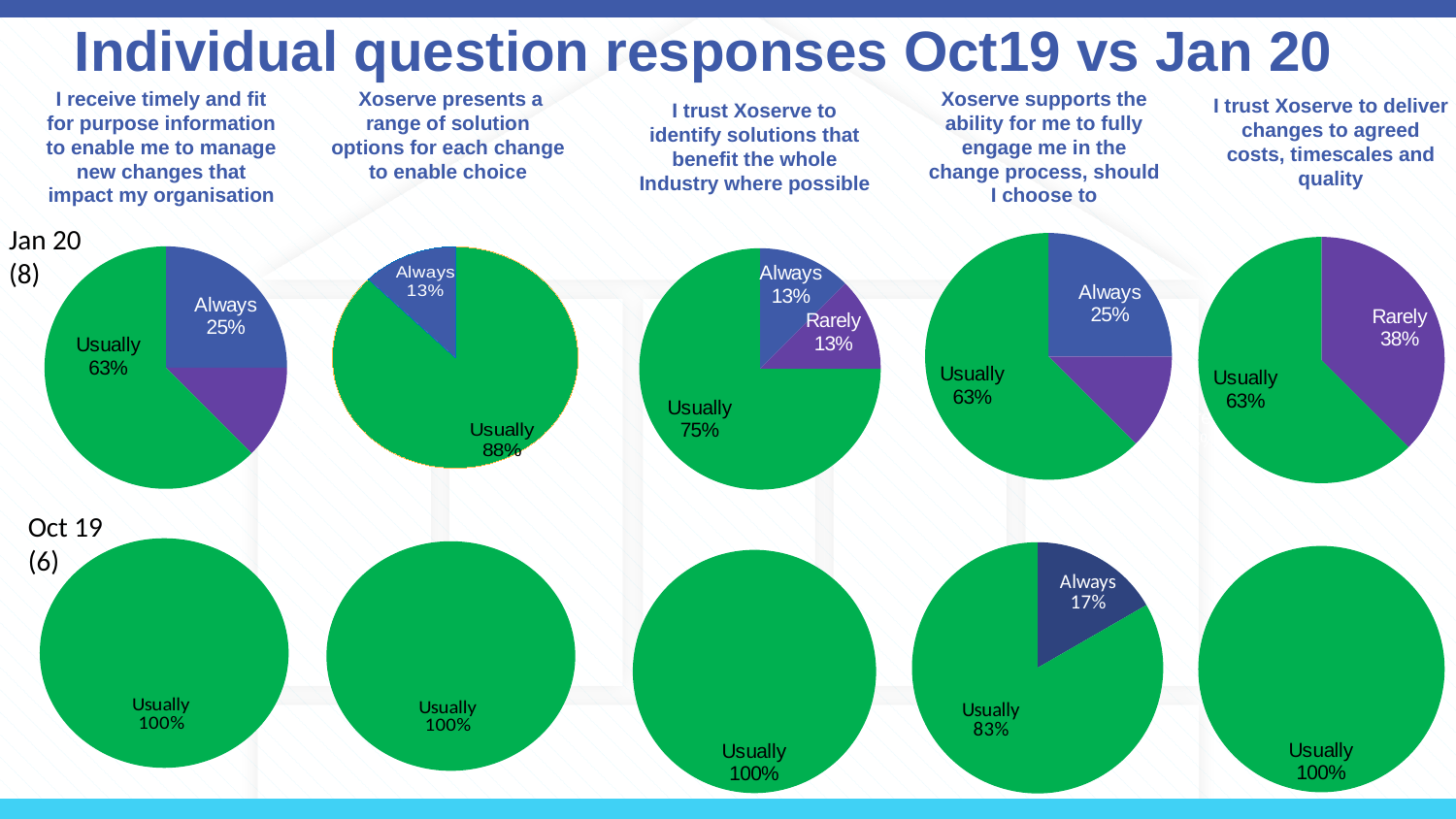
In the Jan 20 pie chart for 'I trust Xoserve to deliver changes to agreed costs, timescales and quality', what share of responses is 'Rarely'? 38% What type of chart is used on this slide to show the individual question responses? Pie chart In the Oct 19 pie chart for 'I trust Xoserve to deliver changes to agreed costs, timescales and quality', what share of responses is 'Usually'? 100% In the Jan 20 pie chart for 'I trust Xoserve to identify solutions that benefit the whole Industry where possible', what share of responses is 'Rarely'? 13% In the Oct 19 pie chart for 'Xoserve supports the ability for me to fully engage me in the change process, should I choose to', what share of responses is 'Always'? 17% In the Jan 20 pie chart for 'I trust Xoserve to deliver changes to agreed costs, timescales and quality', what is the difference between the 'Usually' and 'Rarely' shares? 25% In the Jan 20 pie chart for 'I receive timely and fit for purpose information to enable me to manage new changes that impact my organisation', what share of responses is 'Usually'? 63% In the Jan 20 pie chart for 'I receive timely and fit for purpose information to enable me to manage new changes that impact my organisation', what share of responses is 'Always'? 25% In the Jan 20 pie chart for 'I trust Xoserve to identify solutions that benefit the whole Industry where possible', which response has the largest share? Usually In the Jan 20 pie chart for 'Xoserve presents a range of solution options for each change to enable choice', what share of responses is 'Usually'? 88% Which is larger in the Jan 20 pie chart for 'Xoserve presents a range of solution options for each change to enable choice': the 'Always' share or the 'Usually' share? Usually How many pie charts are shown on the slide in total? 10